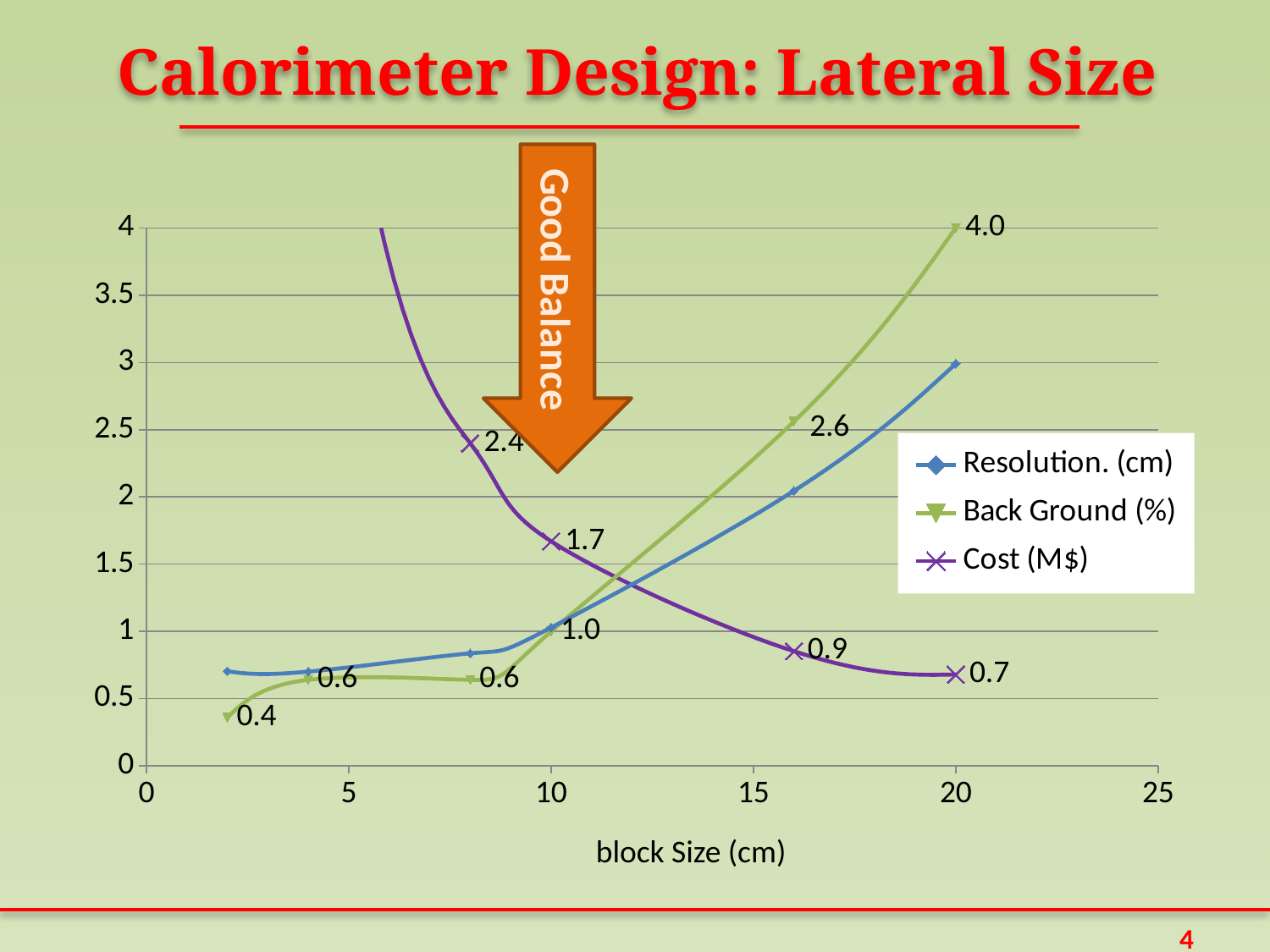
What is the Cost (M$) value at a block size of 16 cm? 0.9 What is the Back Ground (%) value at a block size of 20 cm? 4.0 Does the Cost (M$) series rise or fall as block size increases? fall What is the Back Ground (%) value at a block size of 2 cm? 0.4 What is the difference between the Cost (M$) values at block sizes of 8 cm and 20 cm? 1.7 At a block size of 16 cm, which is larger: Back Ground (%) or Cost (M$)? Back Ground (%) How many series does the legend list? 3 What kind of chart is shown on the slide? line chart Is the Resolution (cm) value at a block size of 20 cm greater or less than 2.5? greater Does the Back Ground (%) series rise or fall as block size increases? rise What is the Cost (M$) value at a block size of 20 cm? 0.7 What is the Cost (M$) value at a block size of 8 cm? 2.4